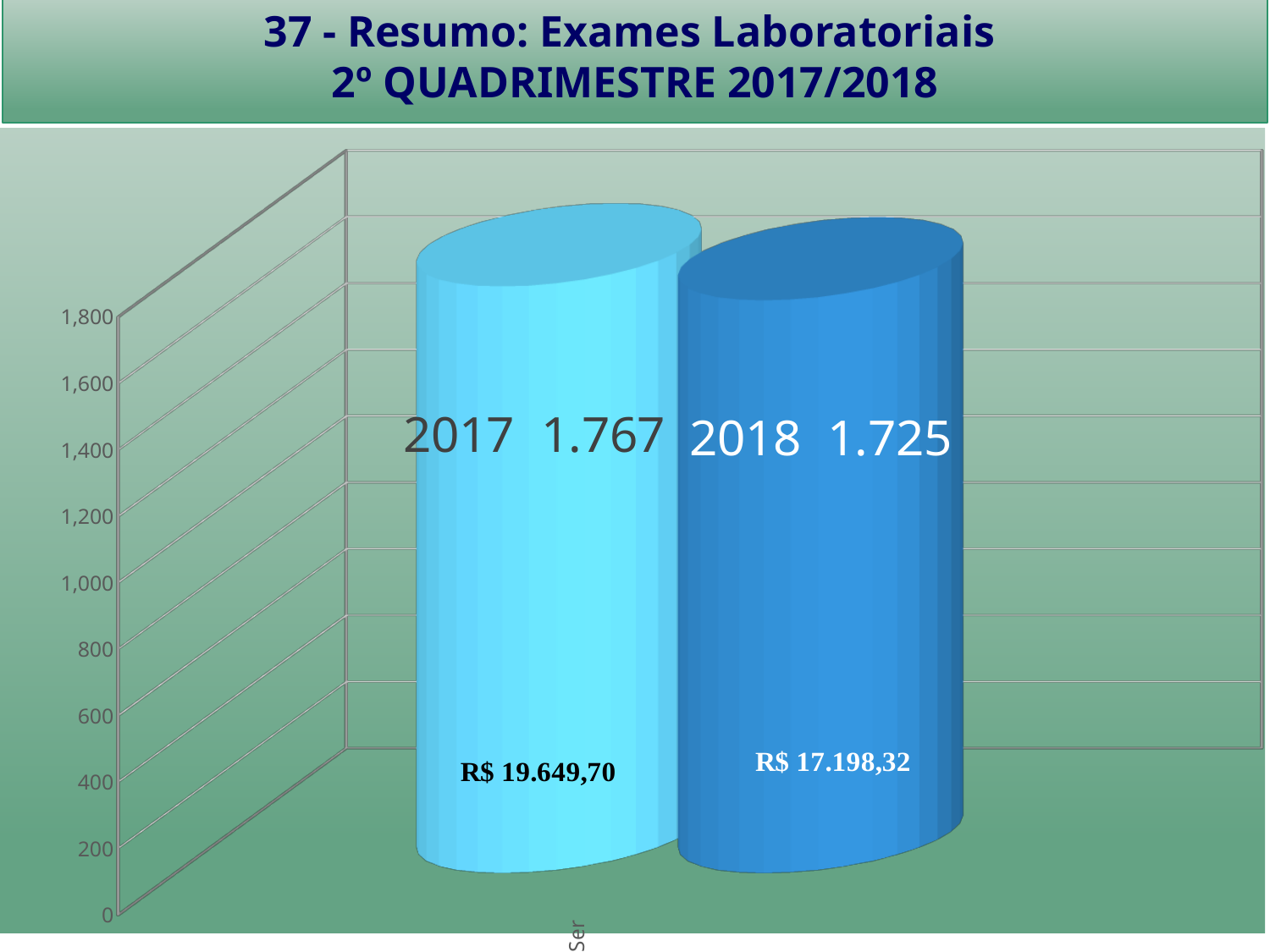
What R$ amount is printed on the 2017 bar? R$ 19.649,70 What kind of chart is shown on the slide? bar chart How many bars are plotted in the chart? 2 Which year has the lower value? 2018 Is the value for 2018 larger or smaller than the value for 2017? smaller What is the difference between the 2017 value (1.767) and the 2018 value (1.725)? 42 What is the value shown for 2017? 1.767 Do the values rise or fall from 2017 to 2018? fall Is the value for 2017 greater or less than 1,600? greater What is the value shown for 2018? 1.725 Which year has the higher value? 2017 What R$ amount is printed on the 2018 bar? R$ 17.198,32